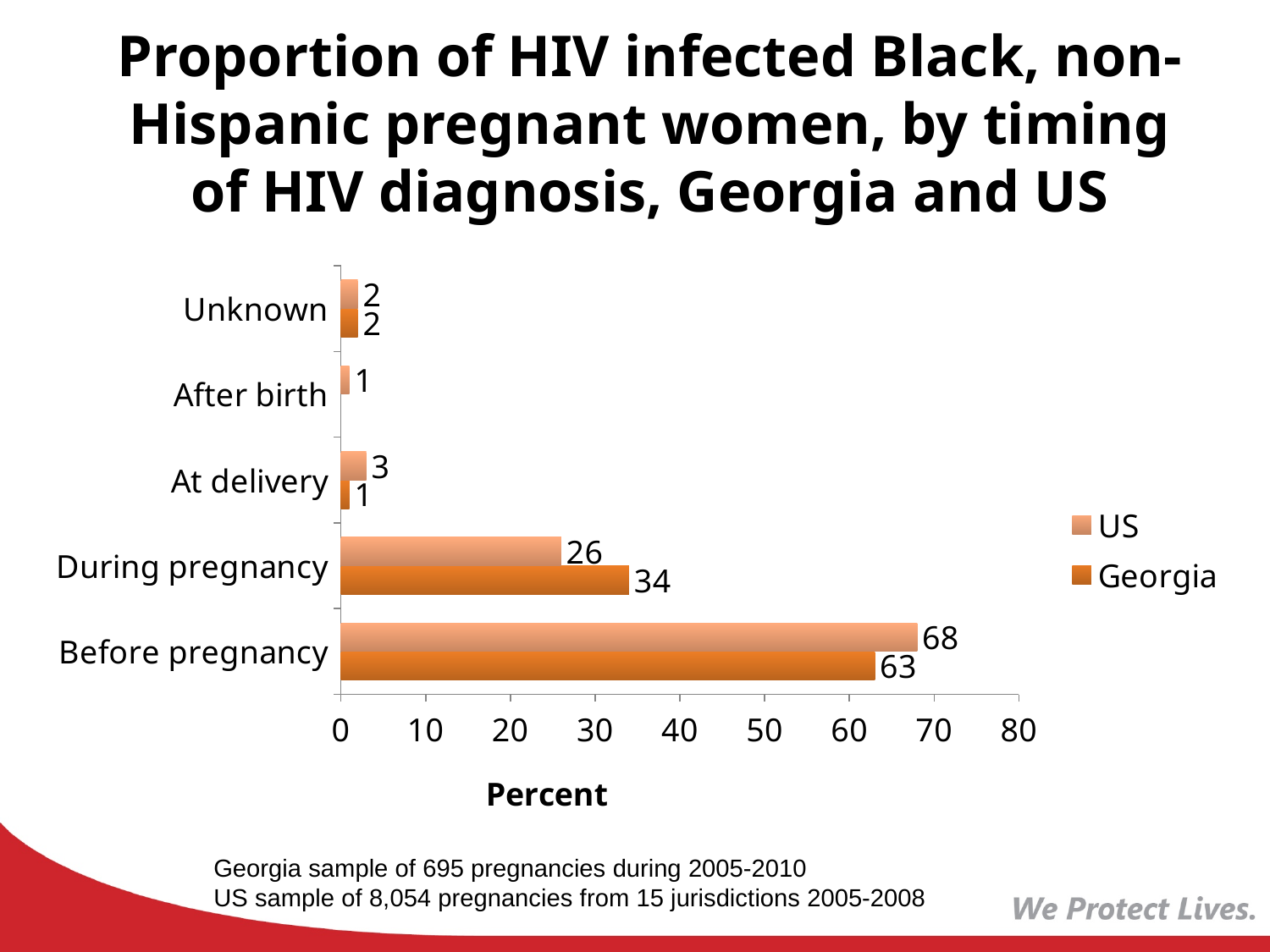
What is the US value for Before pregnancy? 68 Which is larger for During pregnancy, the US value or the Georgia value? Georgia What is the US value for At delivery? 3 How many categories are shown on the y axis? 5 How many series does the legend list? 2 Which category has the highest Georgia value? Before pregnancy What is the difference between the US and Georgia values for Before pregnancy? 5 What is the Georgia value for During pregnancy? 34 Is the US value for Before pregnancy greater or less than 60? greater What kind of chart is shown on the slide? Bar chart What is the difference between the US and Georgia values for During pregnancy? 8 What is the Georgia value for Before pregnancy? 63